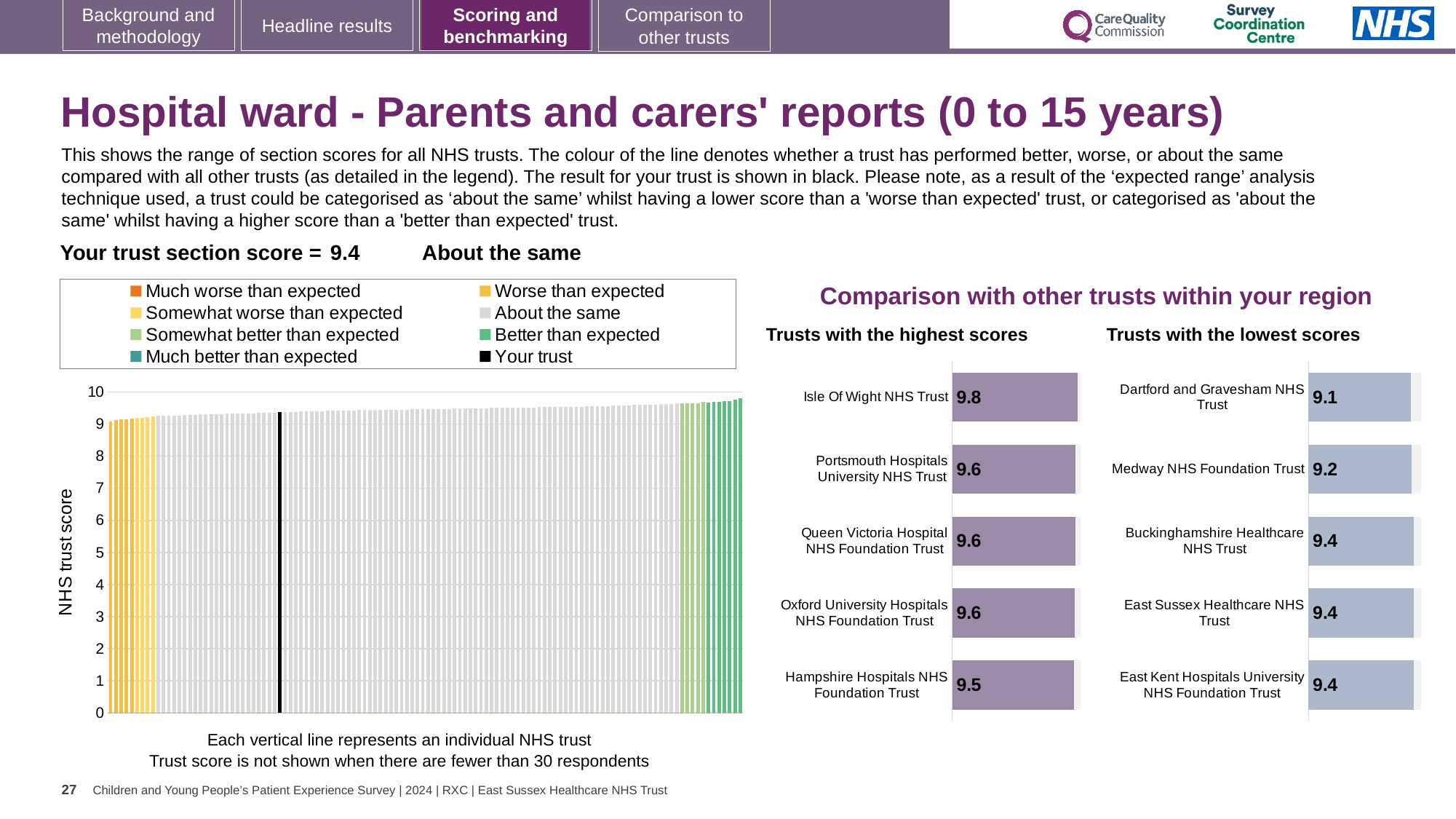
In the 'Trusts with the highest scores' chart, how many trusts are listed? 5 In the 'Trusts with the lowest scores' chart, what is the score for East Sussex Healthcare NHS Trust? 9.4 How many entries does the legend of the large chart on the left list? 8 In the 'Trusts with the highest scores' chart, which trust has the highest score? Isle Of Wight NHS Trust In the 'Trusts with the highest scores' chart, what is the score for Isle Of Wight NHS Trust? 9.8 In the 'Trusts with the lowest scores' chart, what is the difference between the scores of Medway NHS Foundation Trust and Dartford and Gravesham NHS Trust? 0.1 In the 'Trusts with the lowest scores' chart, which has the larger score: Medway NHS Foundation Trust or Dartford and Gravesham NHS Trust? Medway NHS Foundation Trust In the 'Trusts with the highest scores' chart, what is the difference between the scores of Isle Of Wight NHS Trust and Hampshire Hospitals NHS Foundation Trust? 0.3 In the 'Trusts with the lowest scores' chart, what is the score for Dartford and Gravesham NHS Trust? 9.1 In the 'Trusts with the highest scores' chart, what is the score for Hampshire Hospitals NHS Foundation Trust? 9.5 In the large chart on the left showing NHS trust scores, is the value for the black 'Your trust' line greater or less than 9? greater In the 'Trusts with the lowest scores' chart, which trust has the lowest score? Dartford and Gravesham NHS Trust